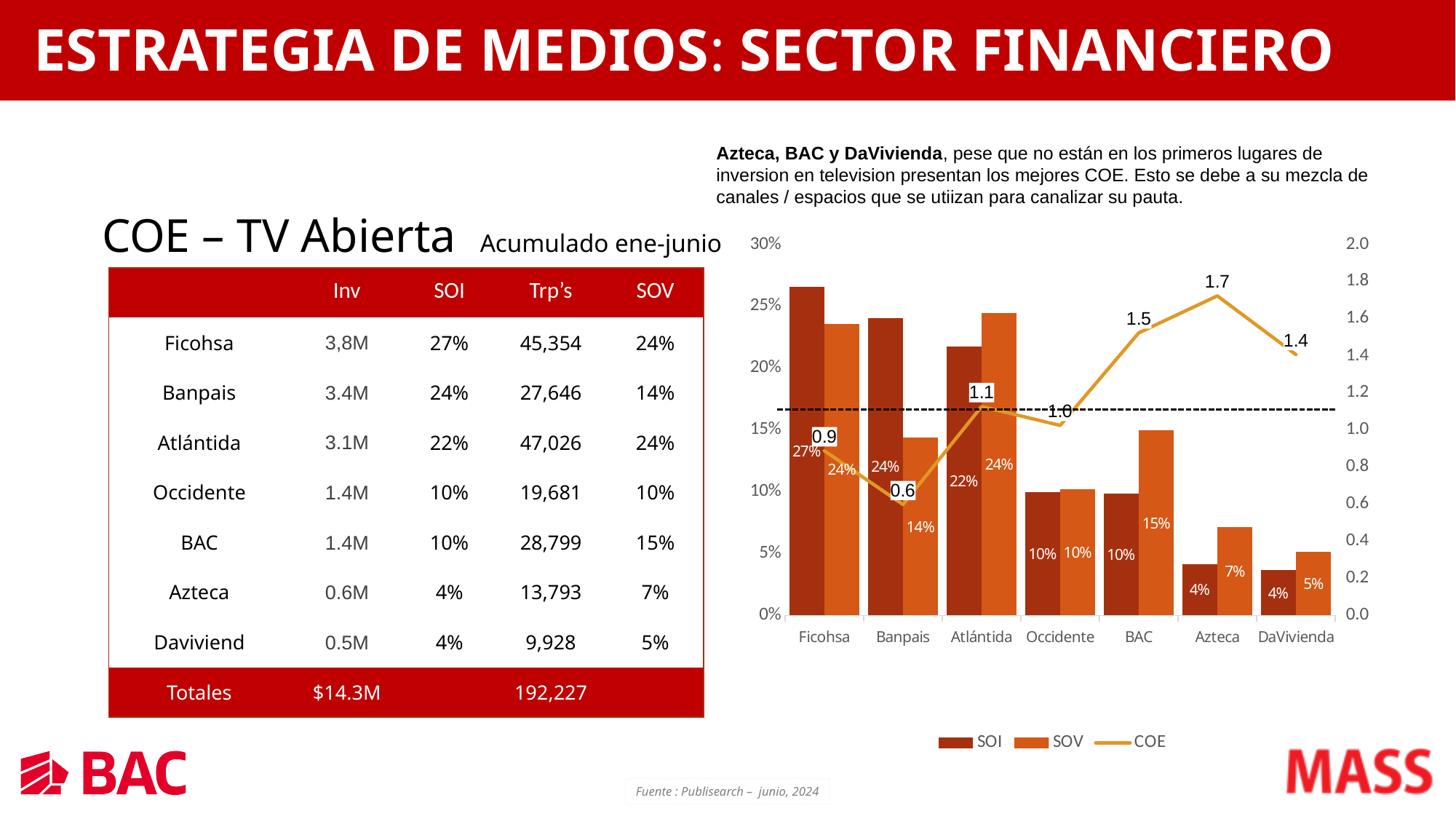
What is the SOI value for Ficohsa? 27% Which category has the highest COE value? Azteca What is the COE value for Banpais? 0.6 How many categories are shown on the x axis of the chart? 7 Which series in the chart is drawn as a line rather than bars? COE What is the difference between the SOI and SOV values for Banpais? 10% What is the COE value for Azteca? 1.7 Which category has the highest SOI value? Ficohsa What is the SOV value for BAC? 15% How many series does the chart legend list? 3 Which category has the lowest COE value? Banpais Which is larger for Atlántida, the SOI value or the SOV value? SOV